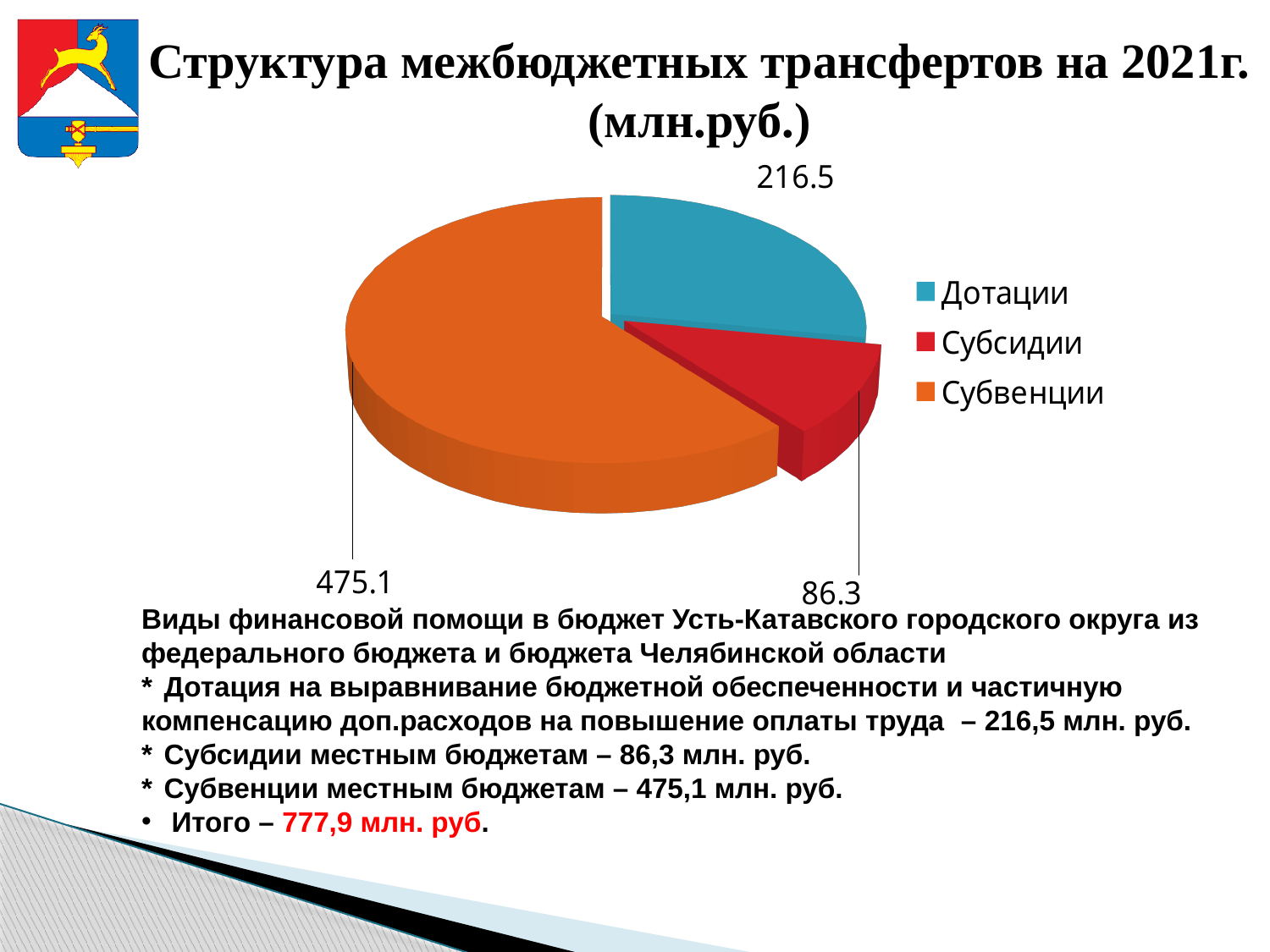
Which category has the largest slice in the pie chart? Субвенции What is the total of all slices in the pie chart? 777.9 What is the value for Субсидии in the pie chart? 86.3 Which is larger, the value for Дотации or the value for Субсидии? Дотации How many categories does the pie chart have? 3 What is the difference between the values for Субвенции and Дотации? 258.6 What is the value for Дотации in the pie chart? 216.5 What colour is the Субвенции slice in the pie chart? Orange What is the value for Субвенции in the pie chart? 475.1 What type of chart is shown on the slide? Pie chart Which category has the smallest slice in the pie chart? Субсидии What is the difference between the values for Дотации and Субсидии? 130.2